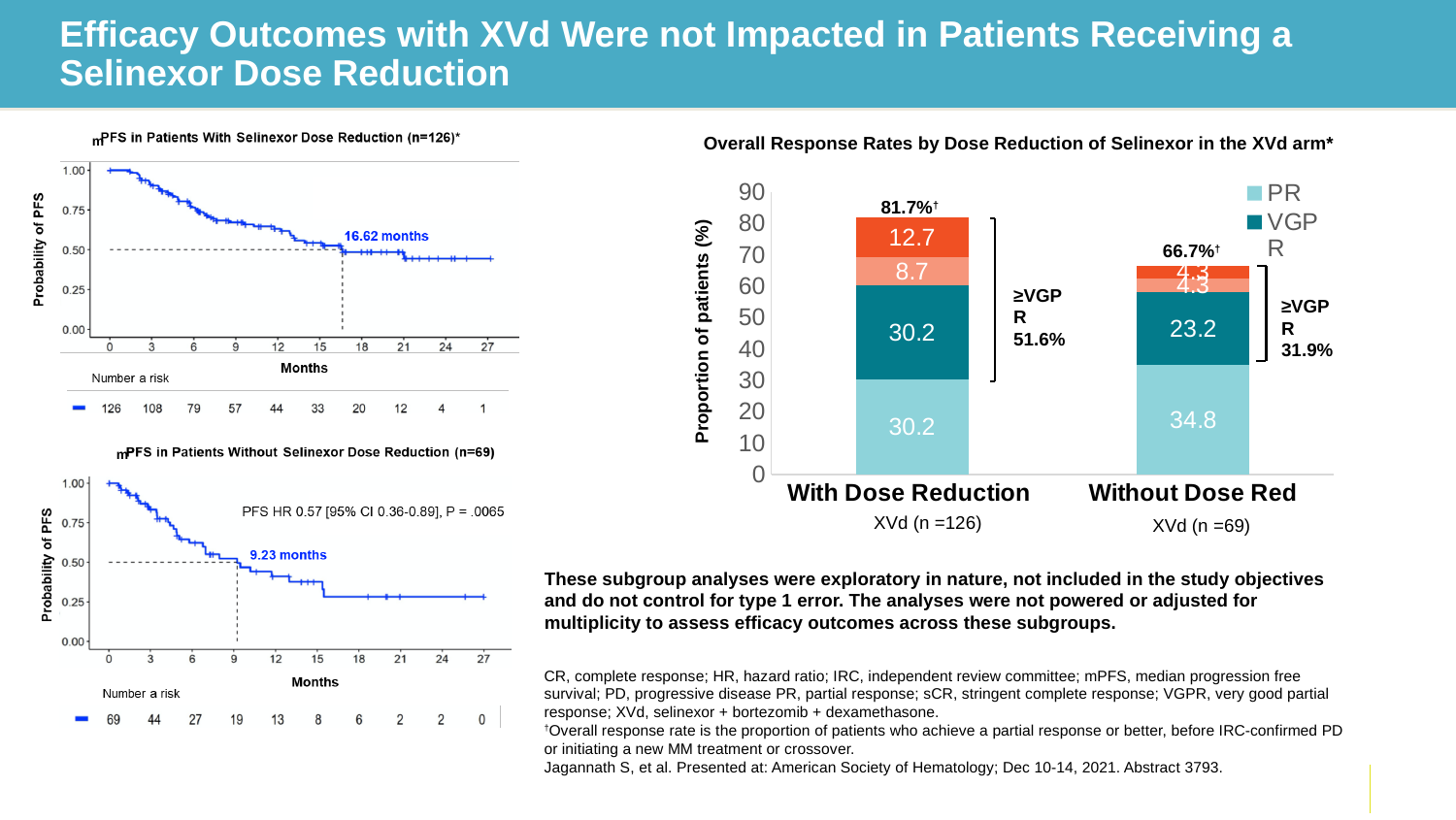
In the Overall Response Rates chart, what is the VGPR proportion for the Without Dose Reduction group? 23.2 In the bottom-left chart, how many patients are at risk at 0 months? 69 In the Overall Response Rates chart, what is the overall response rate for the With Dose Reduction group? 81.7% In the Overall Response Rates chart, what is the PR proportion for the With Dose Reduction group? 30.2 In the Overall Response Rates chart, what is the PR proportion for the Without Dose Reduction group? 34.8 In the top-left chart, how many patients are at risk at 12 months? 44 In the Overall Response Rates chart, what is the difference in ≥VGPR rate between the With Dose Reduction and Without Dose Reduction groups? 19.7 percentage points What kind of chart is the Overall Response Rates chart on the right? Stacked bar chart In the bottom-left chart, what is the PFS hazard ratio shown? 0.57 In the top-left chart, what is the median PFS in patients with selinexor dose reduction? 16.62 months In the bottom-left chart, what is the median PFS in patients without selinexor dose reduction? 9.23 months In the Overall Response Rates chart, which group has the larger VGPR proportion? With Dose Reduction